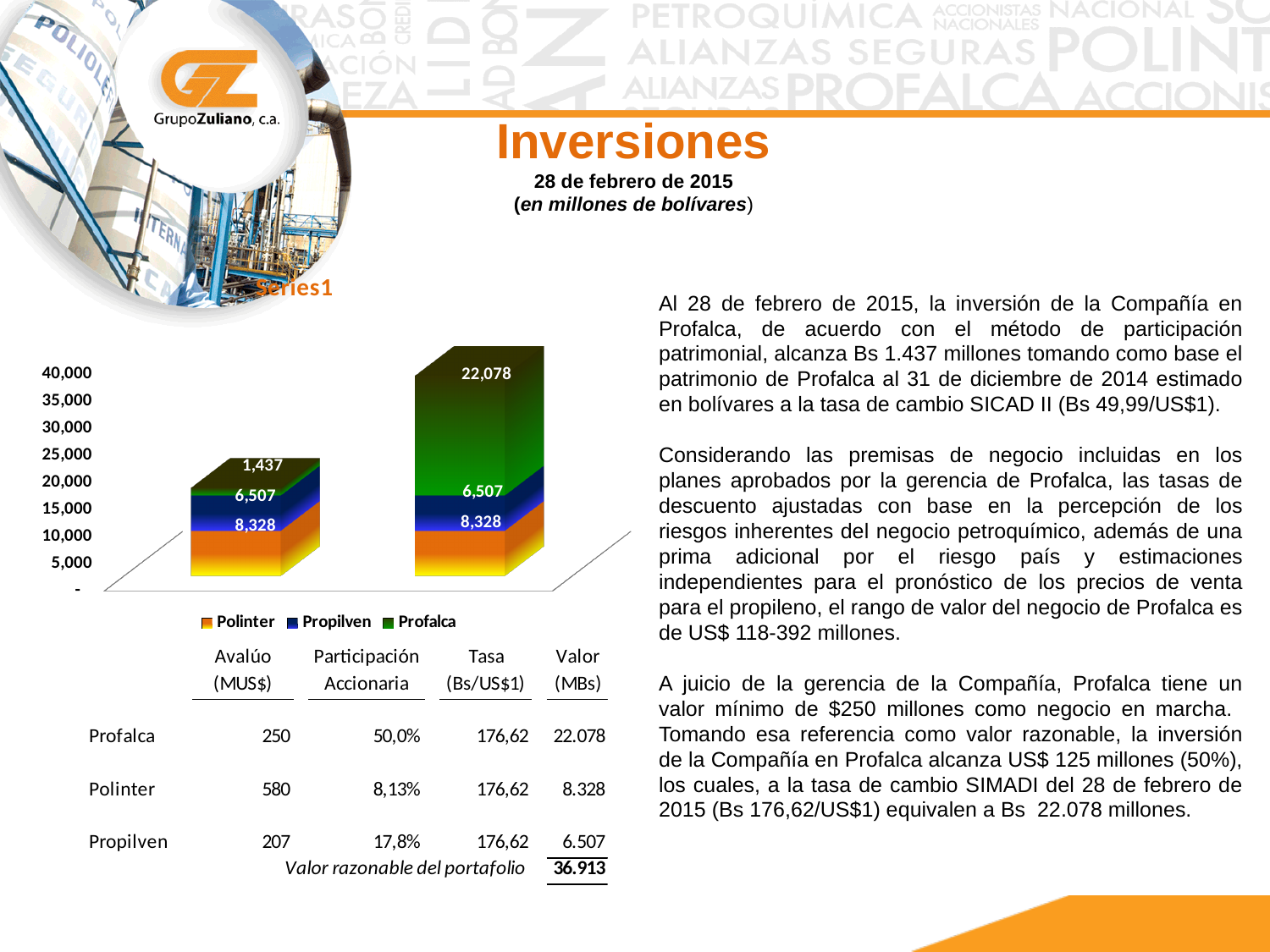
Which series are listed in the chart legend? Polinter, Propilven, Profalca What is the difference between the Profalca segment in the right bar and the Profalca segment in the left bar? 20,641 How many bars are plotted in the chart? 2 What is the value of the Profalca segment in the left bar? 1,437 What is the total of the left stacked bar? 16,272 How many series does the chart legend list? 3 What is the total of the right stacked bar? 36,913 Which bar is taller, the left bar or the right bar? Right bar What is the value of the Polinter segment in the right bar? 8,328 What is the value of the Profalca segment in the right bar? 22,078 What is the value of the Propilven segment in the left bar? 6,507 What kind of chart is shown on the slide? Stacked bar chart